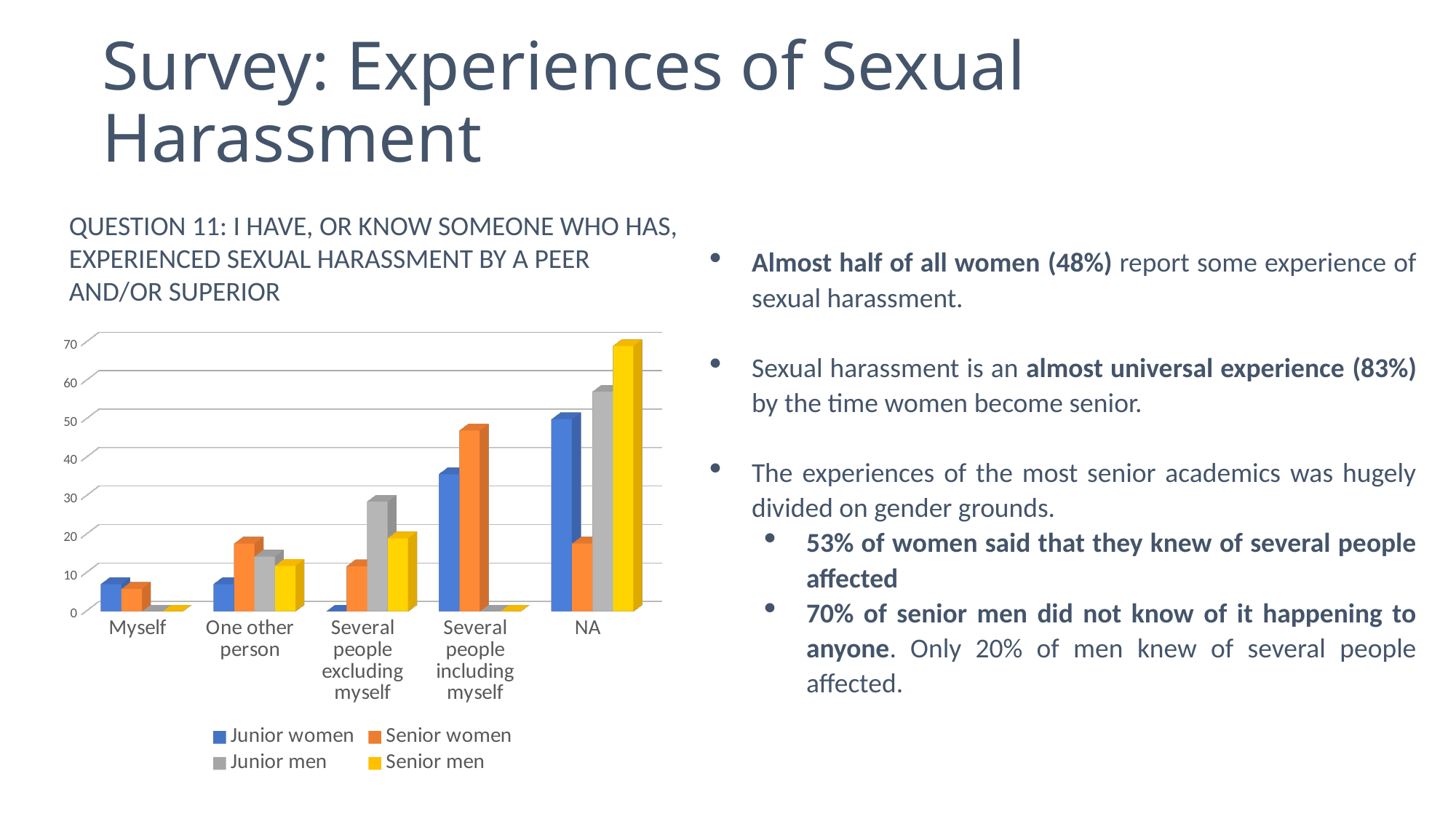
What kind of chart is shown on the slide? bar chart In which category does the Senior men series reach its highest value? NA Is the value for Senior men in the NA category greater or less than 60? greater Is the value for Senior women in the 'One other person' category greater or less than 20? less How many categories are shown on the x axis of the chart? 5 Is the value for Junior men in the 'Several people excluding myself' category greater or less than 20? greater Which series has the highest value in the NA category? Senior men Which series has the lowest value in the NA category? Senior women Which colour represents the Senior men series in the chart's legend? yellow How many series does the chart's legend list? 4 In the 'Several people including myself' category, which is larger: Junior women or Senior women? Senior women